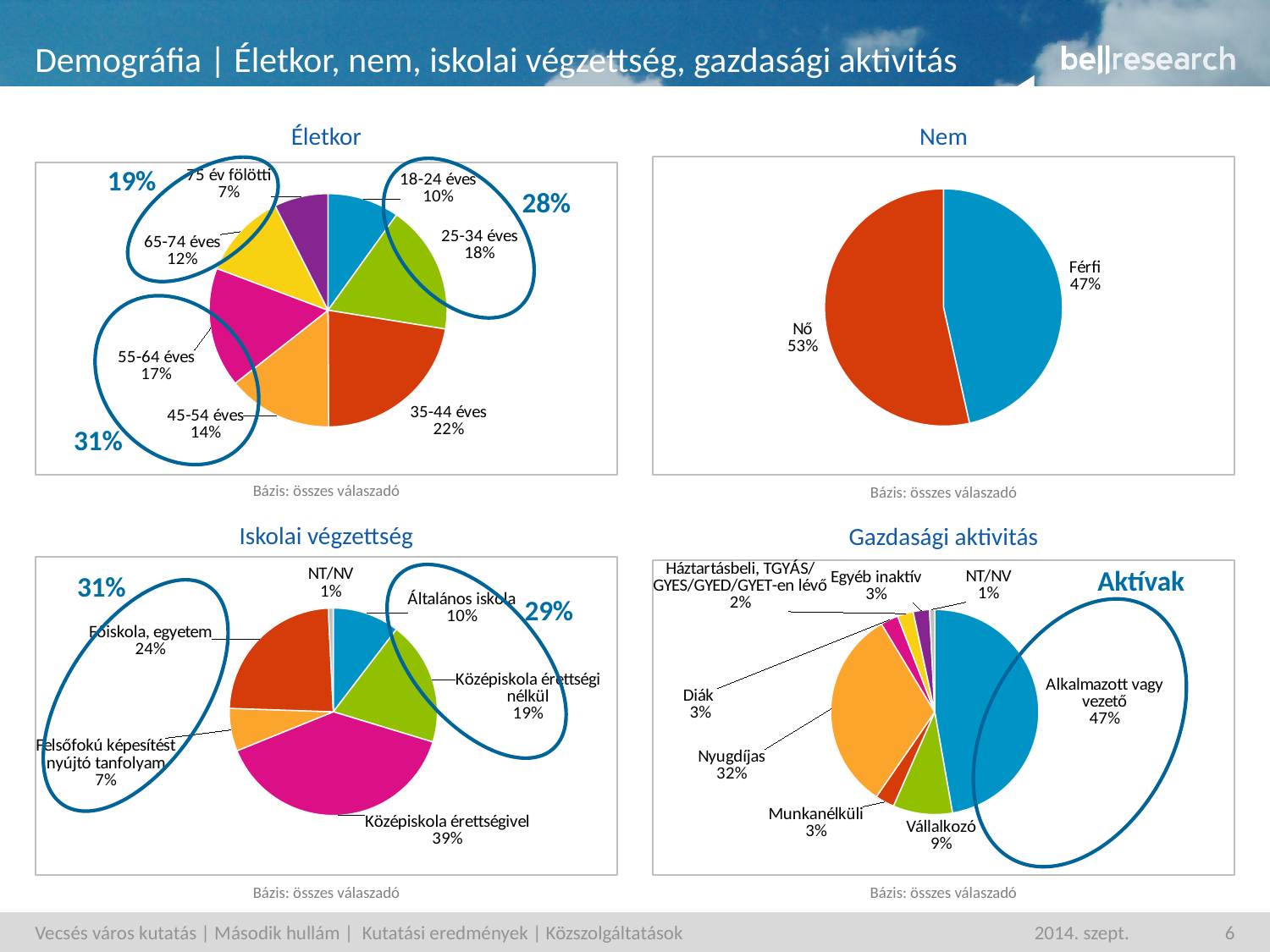
In the Nem chart, what is the difference between the Nő and Férfi shares? 6% In the Gazdasági aktivitás chart, what is the difference between Alkalmazott vagy vezető and Vállalkozó? 38% In the Iskolai végzettség chart, which category has the largest share? Középiskola érettségivel In the Nem chart, what is the share of Nő? 53% In the Iskolai végzettség chart, which is larger: Főiskola, egyetem or Általános iskola? Főiskola, egyetem In the Életkor chart, what share of respondents are 35-44 éves? 22% In the Életkor chart, how many age categories are shown? 7 In the Iskolai végzettség chart, what share has Középiskola érettségivel? 39% In the Életkor chart, which age group has the smallest share? 75 év fölötti What type of chart is the Nem chart? pie chart In the Gazdasági aktivitás chart, what share is Nyugdíjas? 32% In the Gazdasági aktivitás chart, how many categories are shown? 8